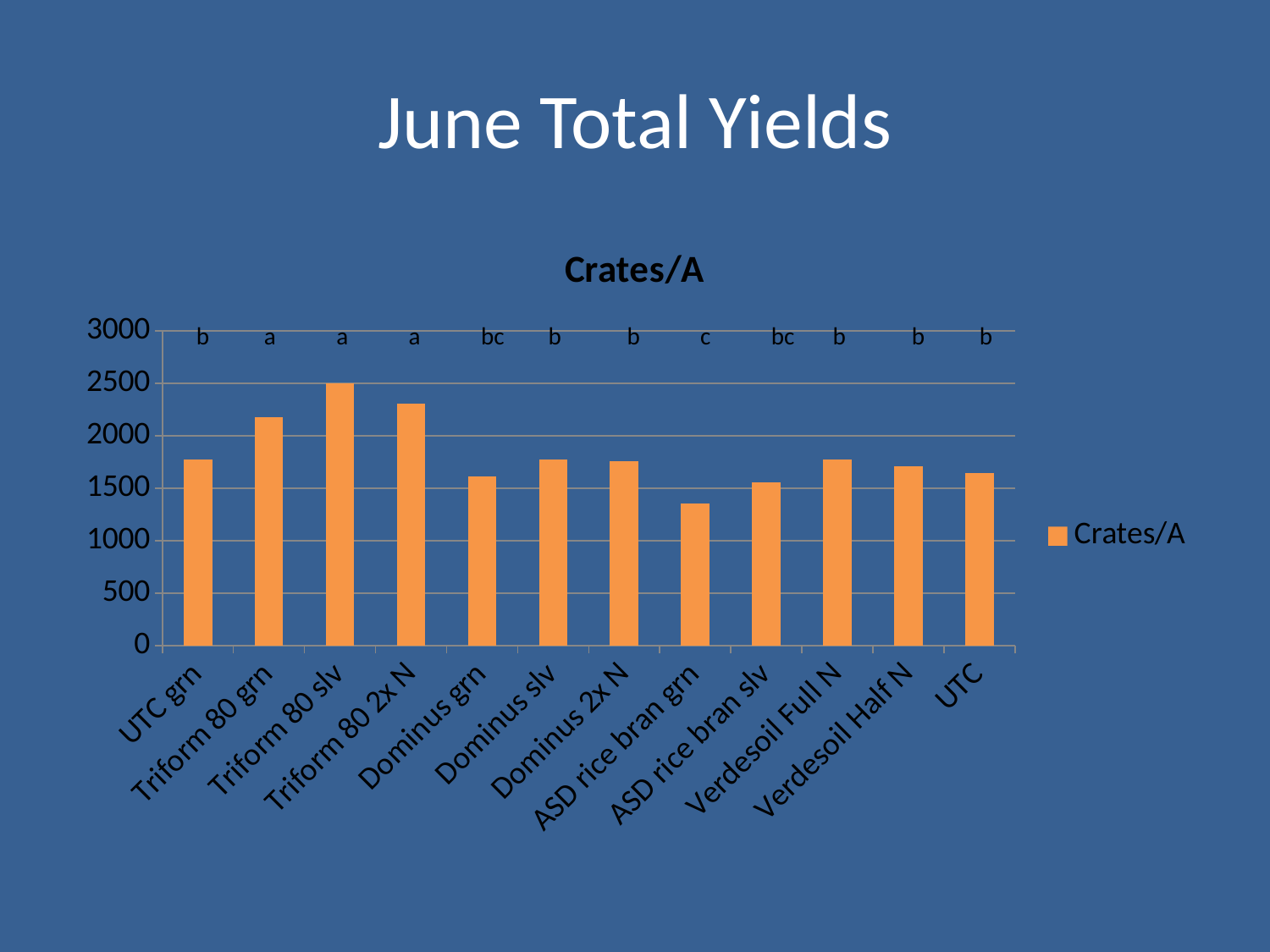
Which is larger, the value for Triform 80 slv or the value for Triform 80 2x N? Triform 80 slv What letter is printed above the bar for ASD rice bran grn? c Which category has the lowest Crates/A value? ASD rice bran grn Is the value for Triform 80 grn greater or less than 2000? greater How many series does the chart's legend list? 1 What type of chart is shown on the slide? bar chart Is the value for Triform 80 2x N greater or less than 2000? greater Which category has the highest Crates/A value? Triform 80 slv How many categories are plotted on the x axis of the chart? 12 Is the value for ASD rice bran grn greater or less than 1500? less Which is larger, the value for Triform 80 grn or the value for Dominus grn? Triform 80 grn